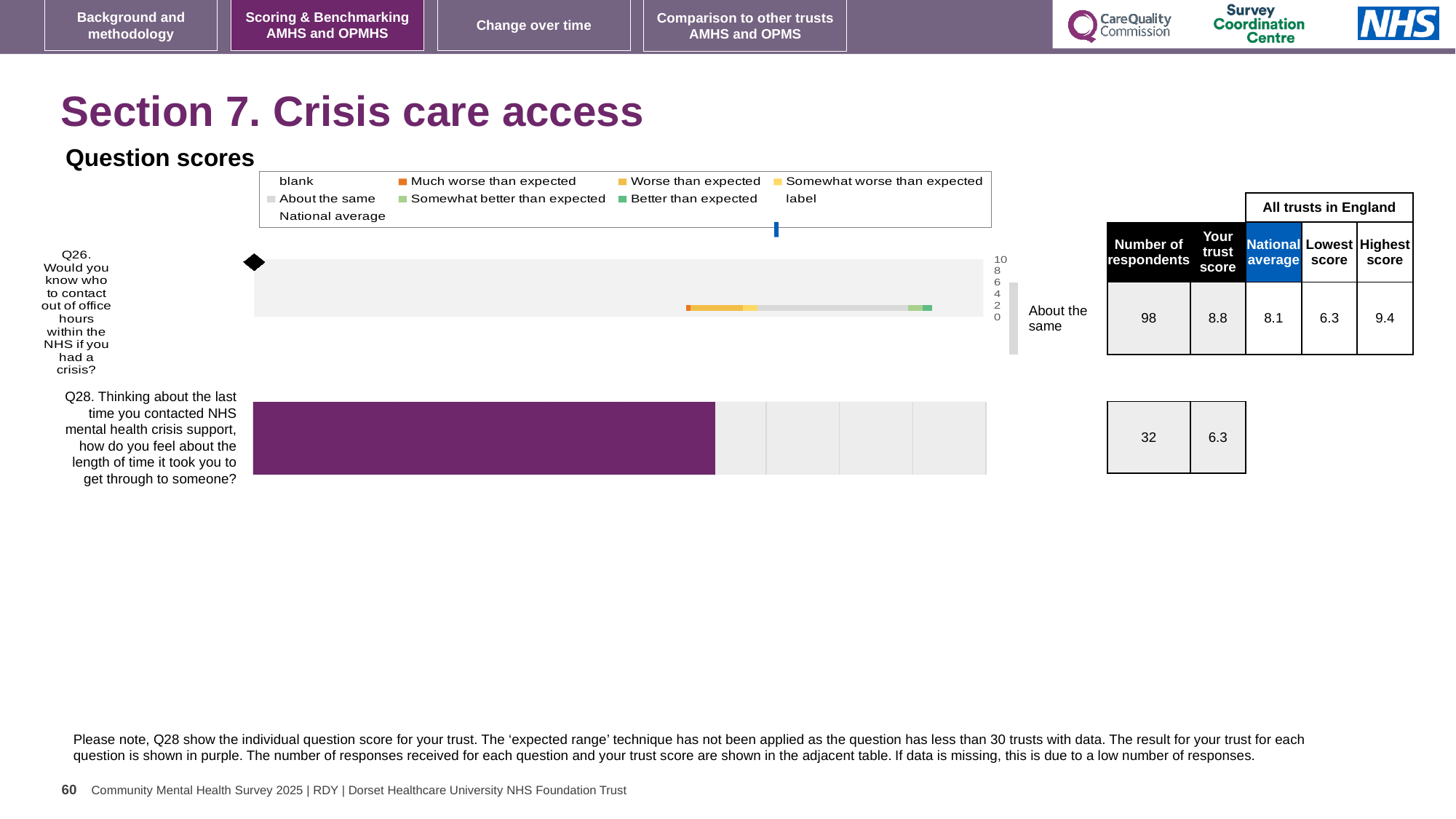
What is the trust score for Q26 (Would you know who to contact out of office hours within the NHS if you had a crisis?)? 8.8 What is the lowest score among all trusts in England for Q26? 6.3 What is the difference between the highest and lowest scores among all trusts in England for Q26? 3.1 How many questions are plotted in the Question scores chart? 2 What is the trust score for Q28 (how do you feel about the length of time it took you to get through to someone)? 6.3 What is the highest score among all trusts in England for Q26? 9.4 What is the national average score for Q26? 8.1 What is the difference between the trust score and the national average for Q26? 0.7 How many respondents answered Q28? 32 How many respondents answered Q26? 98 Is the trust score for Q26 higher or lower than the national average for Q26? higher How is the trust's Q26 result categorised relative to the expected range? About the same